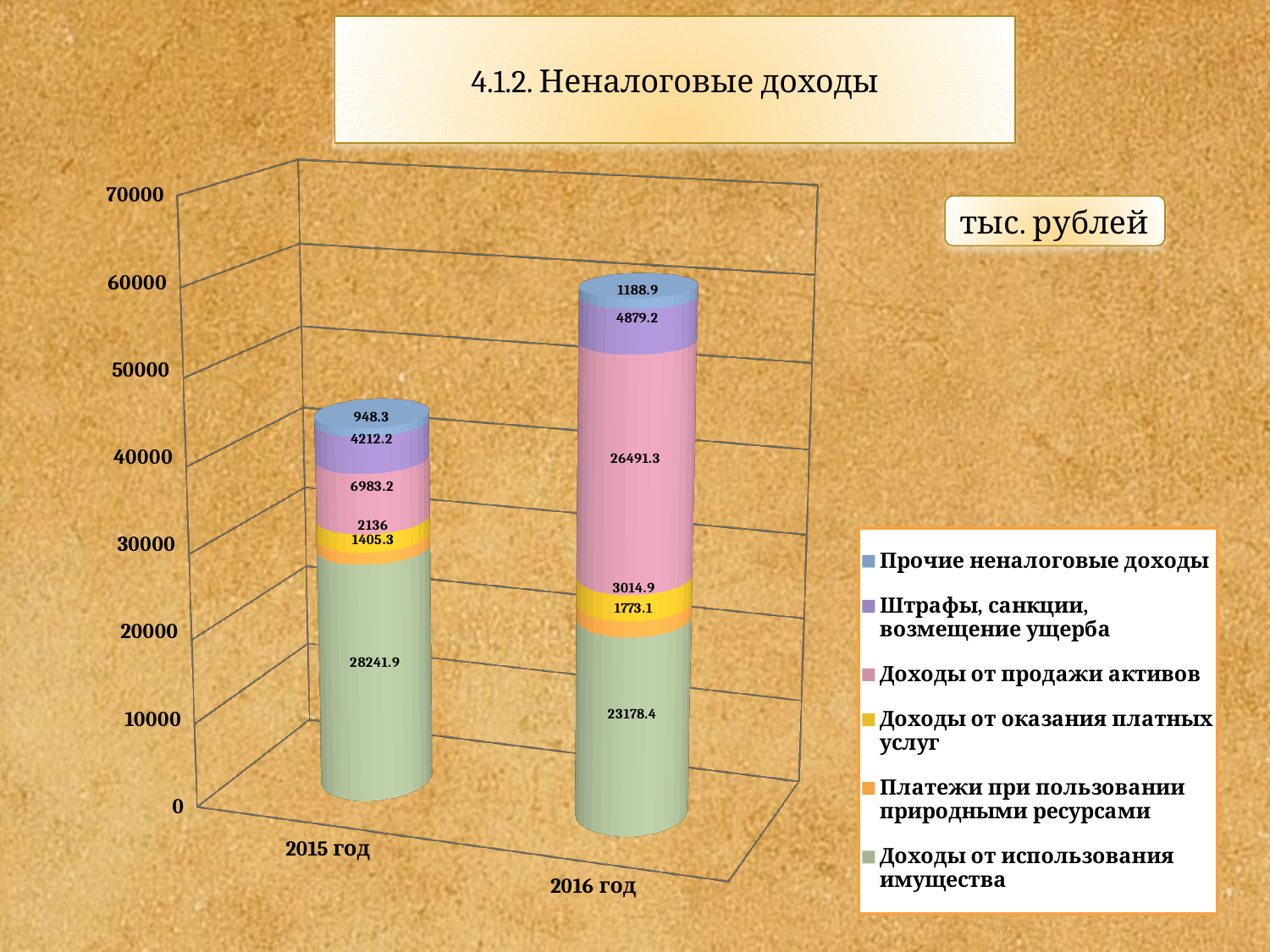
What is the difference between the Штрафы, санкции, возмещение ущерба values for 2016 год and 2015 год? 667 How many series does the legend list? 6 What is the value for Штрафы, санкции, возмещение ущерба in 2015 год? 4212.2 What kind of chart is shown on the slide? Stacked bar chart What is the difference between the Доходы от продажи активов values for 2016 год and 2015 год? 19508.1 What is the value for Доходы от использования имущества in 2015 год? 28241.9 Which year has the larger value for Доходы от продажи активов, 2015 год or 2016 год? 2016 год What is the value for Доходы от продажи активов in 2016 год? 26491.3 What is the total of the stacked bar for 2016 год? 60525.8 What unit is stated for the values on the slide? тыс. рублей What is the value for Прочие неналоговые доходы in 2016 год? 1188.9 What is the value for Доходы от оказания платных услуг in 2015 год? 2136